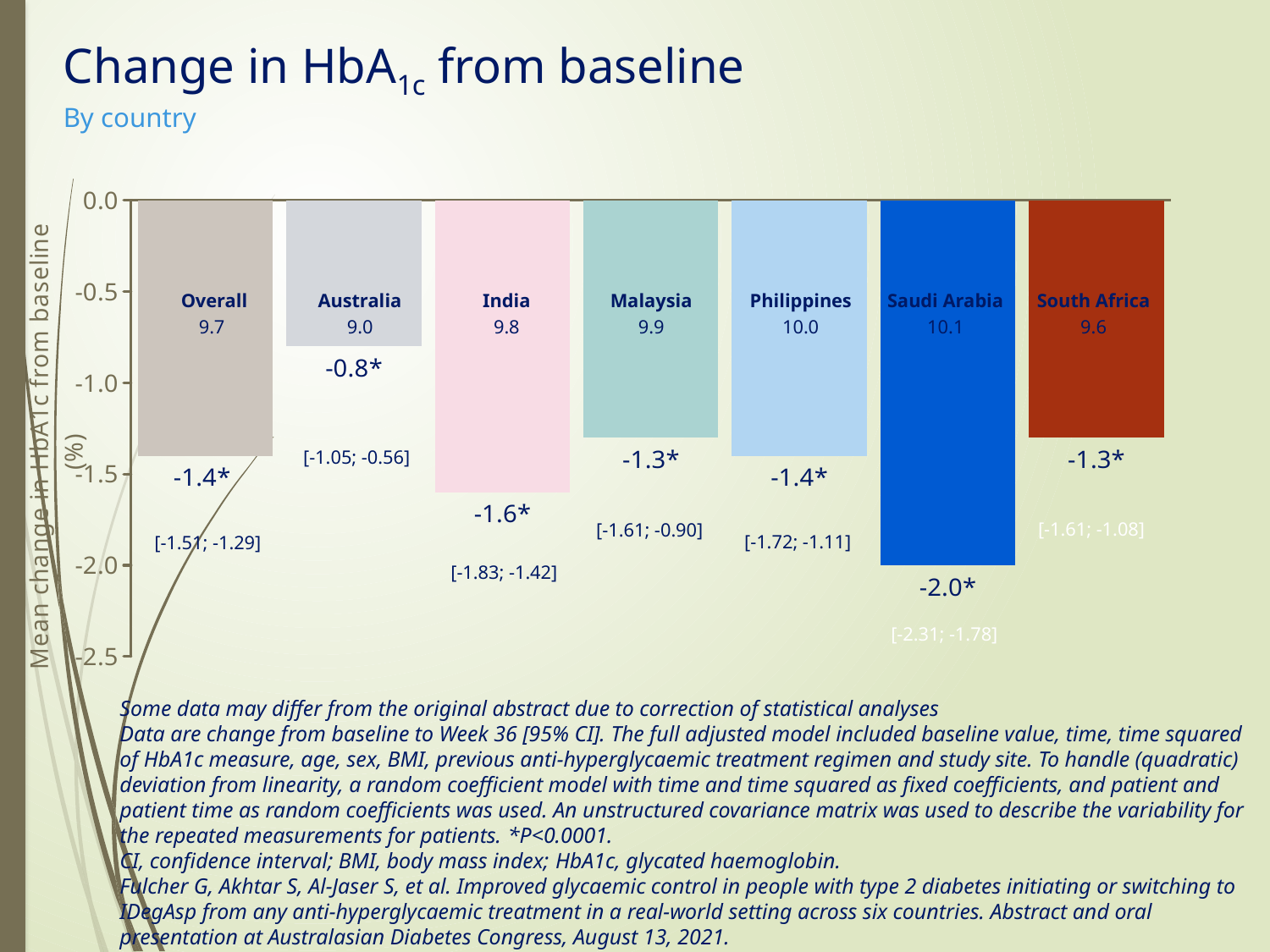
What is the mean change in HbA1c from baseline for Saudi Arabia? -2.0 What baseline HbA1c value is printed on the Philippines bar? 10.0 Which country shows the largest reduction in HbA1c from baseline? Saudi Arabia What is the mean change in HbA1c from baseline for Australia? -0.8 How many bars are shown in the chart? 7 How much larger is the HbA1c reduction for Saudi Arabia than for Australia? 1.2 What type of chart is shown on the slide? Bar chart What is the mean change in HbA1c from baseline for India? -1.6 Which country shows the smallest reduction in HbA1c from baseline? Australia Which has a larger reduction in HbA1c from baseline, India or Malaysia? India Is the value for Saudi Arabia greater or less than -1.5? less What is the 95% confidence interval printed for India? [-1.83; -1.42]